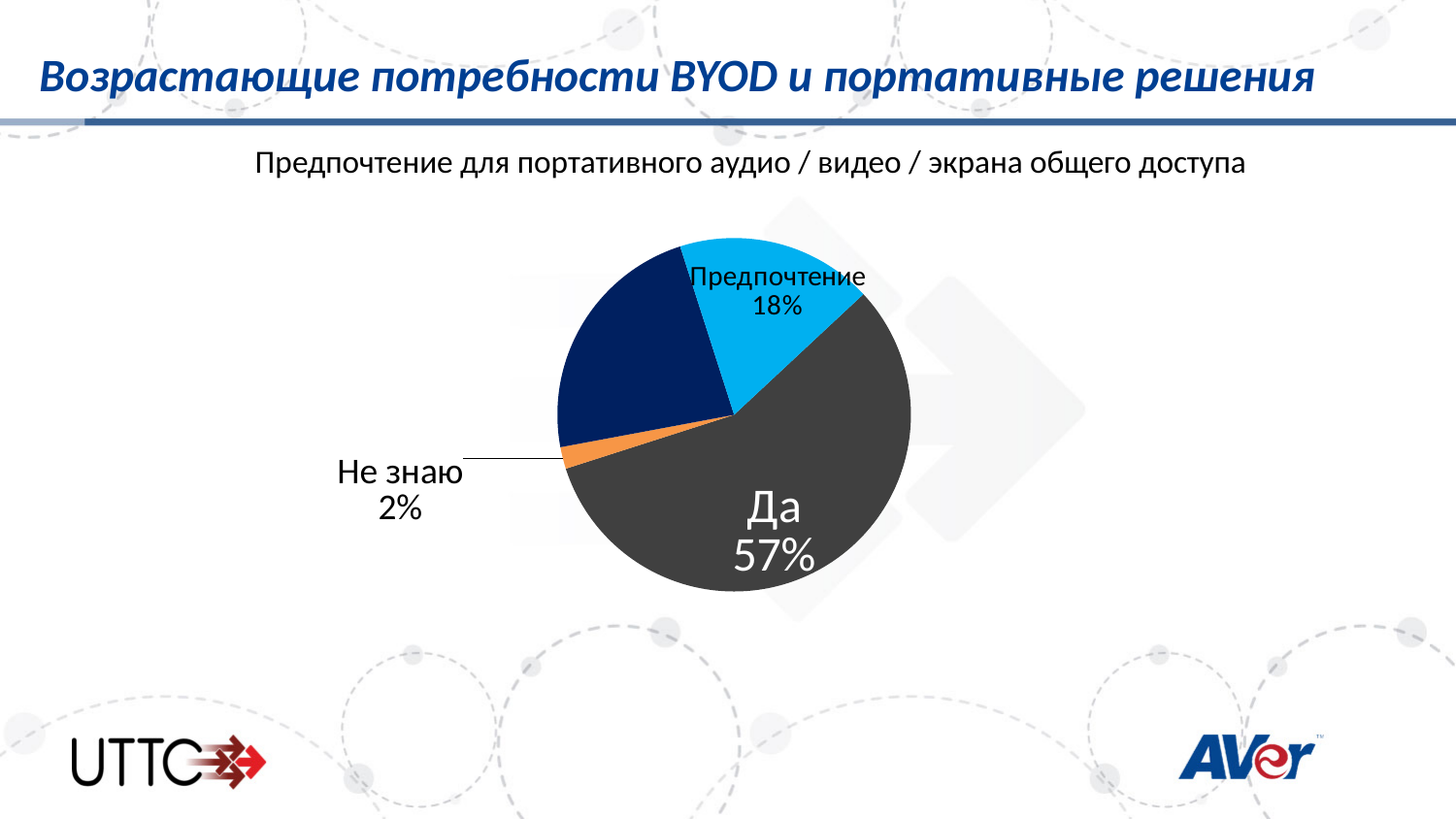
What is the combined share of the "Да" and "Предпочтение" slices? 75% What type of chart is shown on the slide? Pie chart How many slices does the pie chart have? 4 What percentage of the pie chart is the "Да" slice? 57% What colour is the "Да" slice of the pie chart? Dark grey What percentage is shown for the "Предпочтение" slice? 18% Which labeled slice of the pie chart is the largest? Да What is the title of the chart? Предпочтение для портативного аудио / видео / экрана общего доступа Which is larger, the "Предпочтение" slice or the "Не знаю" slice? Предпочтение Which labeled slice of the pie chart is the smallest? Не знаю By how many percentage points does the "Да" slice exceed the "Предпочтение" slice? 39 percentage points What percentage is shown for the "Не знаю" slice? 2%